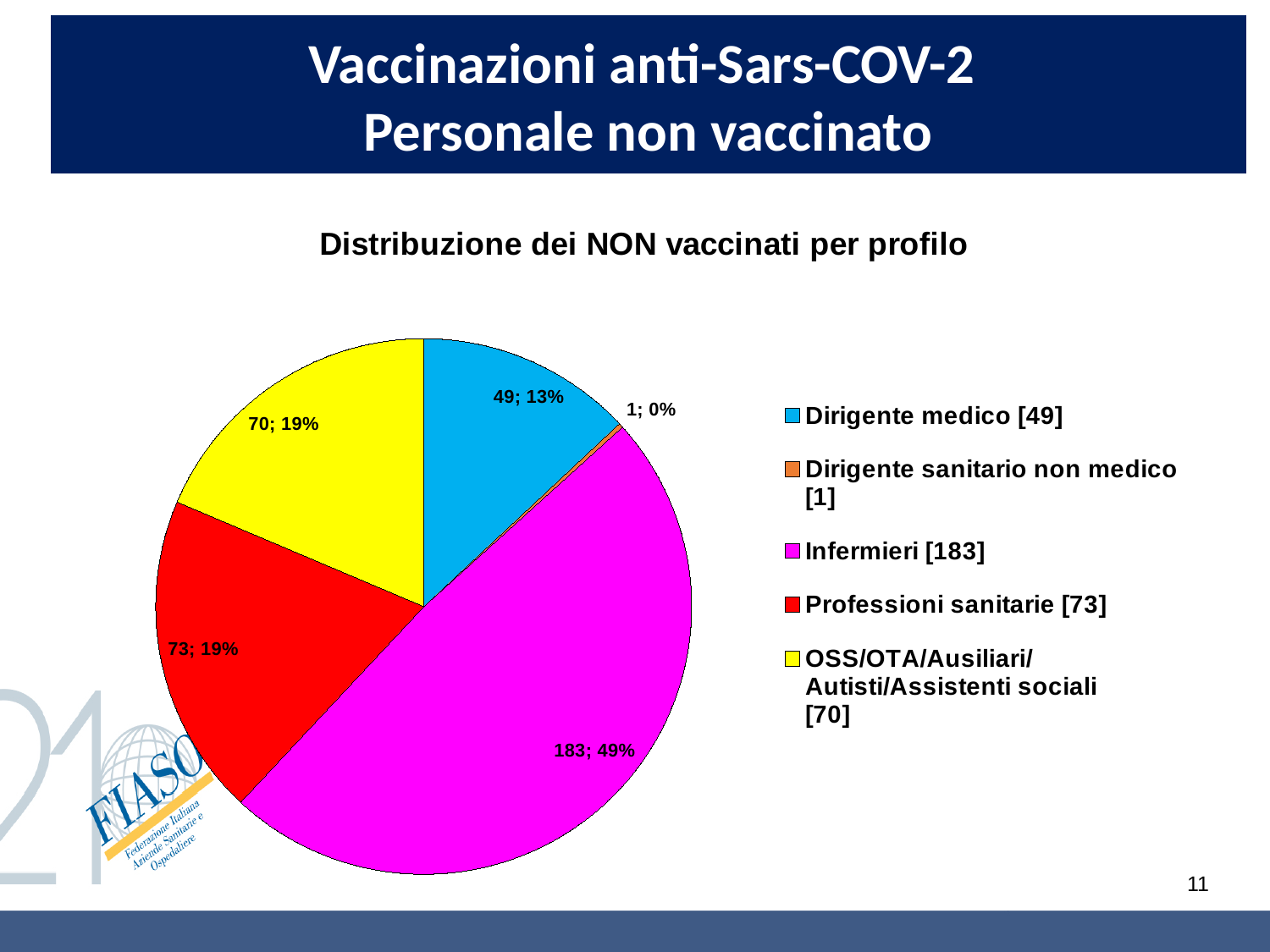
What is the value for Dirigente medico? 49 Which category has the smallest slice? Dirigente sanitario non medico What share of the pie does Infermieri represent? 49% What is the value for Infermieri? 183 What is the value for Professioni sanitarie? 73 What kind of chart is shown on the slide? pie chart What is the chart's title? Distribuzione dei NON vaccinati per profilo Which category has the largest slice? Infermieri What is the difference between the values for Infermieri and OSS/OTA/Ausiliari/Autisti/Assistenti sociali? 113 How many entries does the legend list? 5 Which is larger, the value for Dirigente medico or the value for Professioni sanitarie? Professioni sanitarie How many slices does the pie chart have? 5